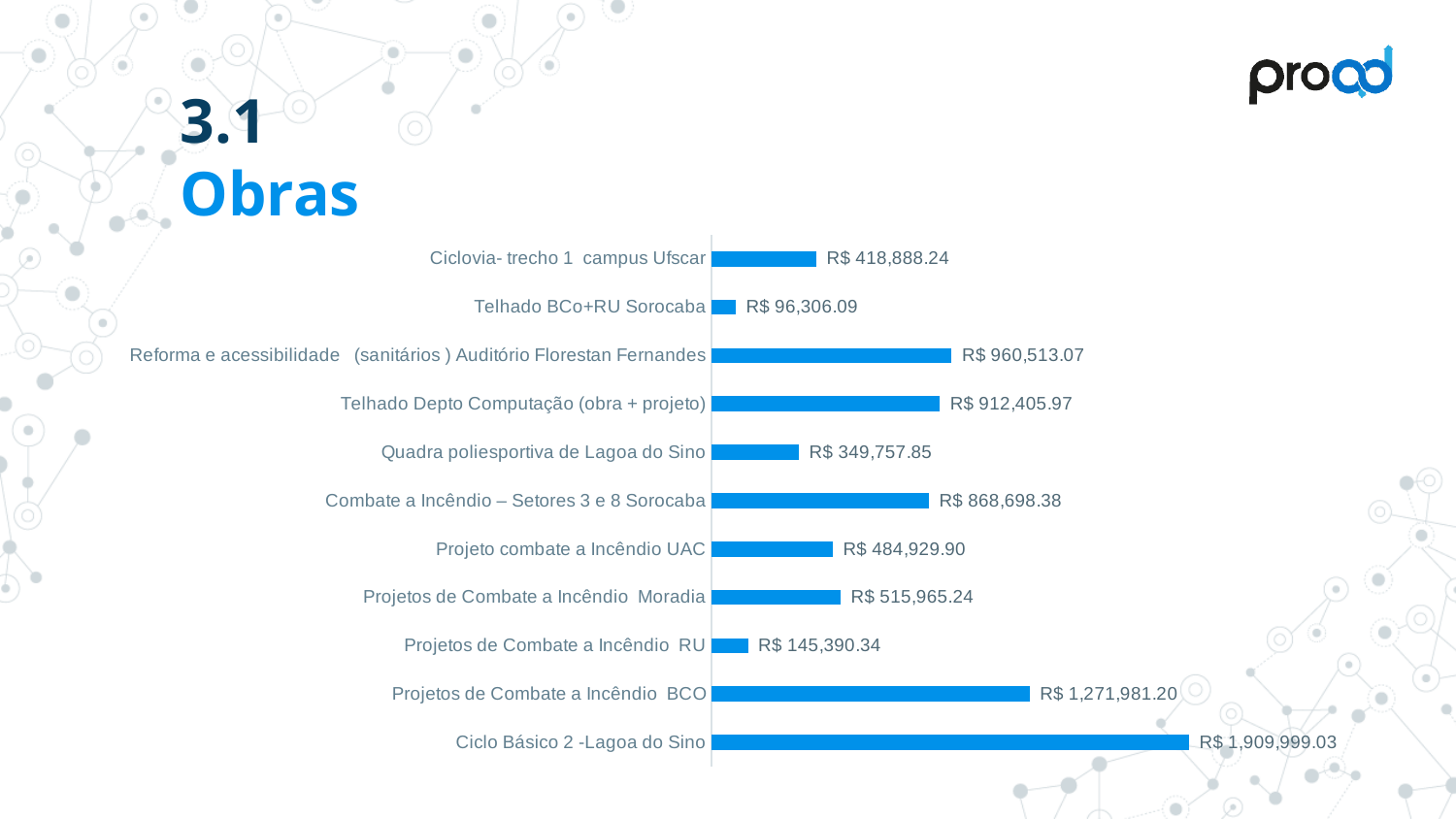
How many categories are shown in the chart? 11 What is the difference between the values for Projetos de Combate a Incêndio Moradia and Projeto combate a Incêndio UAC? R$ 31,035.34 What is the value for Quadra poliesportiva de Lagoa do Sino? R$ 349,757.85 What is the value for Telhado BCo+RU Sorocaba? R$ 96,306.09 Which is larger: the value for Ciclovia- trecho 1 campus Ufscar or the value for Projetos de Combate a Incêndio RU? Ciclovia- trecho 1 campus Ufscar Which category has the lowest value? Telhado BCo+RU Sorocaba Which category has the highest value? Ciclo Básico 2 -Lagoa do Sino What is the value for Projetos de Combate a Incêndio BCO? R$ 1,271,981.20 What is the difference between the values for Ciclo Básico 2 -Lagoa do Sino and Projetos de Combate a Incêndio BCO? R$ 638,017.83 Which is larger: the value for Combate a Incêndio – Setores 3 e 8 Sorocaba or the value for Telhado Depto Computação (obra + projeto)? Telhado Depto Computação (obra + projeto) What is the value for Ciclo Básico 2 -Lagoa do Sino? R$ 1,909,999.03 What kind of chart is shown on the slide? Bar chart